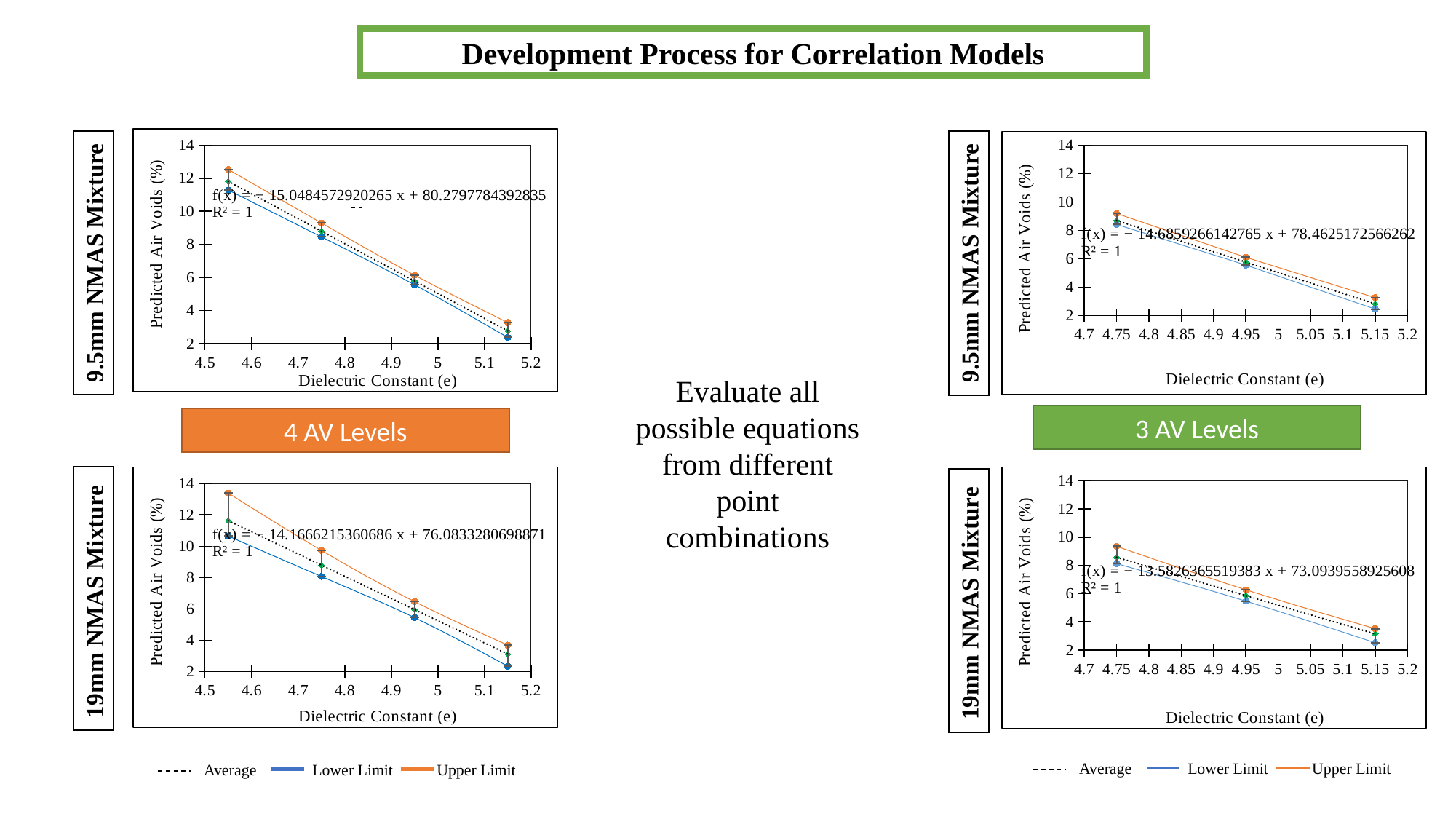
In the bottom-left chart (19mm NMAS Mixture, 4 AV Levels), which series is larger at the leftmost point, Upper Limit or Lower Limit? Upper Limit What kind of chart is the top-left chart (9.5mm NMAS Mixture, 4 AV Levels)? line chart In the top-left chart (9.5mm NMAS Mixture, 4 AV Levels), how many data points does each series have? 4 In the top-right chart (9.5mm NMAS Mixture, 3 AV Levels), is the Upper Limit value at the first (leftmost) point greater or less than 8? greater In the bottom-right chart (19mm NMAS Mixture, 3 AV Levels), which series has the highest values across the points? Upper Limit In the top-left chart (9.5mm NMAS Mixture, 4 AV Levels), do the predicted air voids rise or fall as the dielectric constant increases? fall In the bottom-right chart (19mm NMAS Mixture, 3 AV Levels), how many data points does each series have? 3 What R² value is printed on the top-left chart (9.5mm NMAS Mixture, 4 AV Levels)? R² = 1 In the bottom-left chart (19mm NMAS Mixture, 4 AV Levels), is the Upper Limit value at the first (leftmost) point greater or less than 12? greater How many series does the legend below the left-hand charts list? 3 In the top-left chart (9.5mm NMAS Mixture, 4 AV Levels), is the Upper Limit value at the first (leftmost) point greater or less than 12? greater